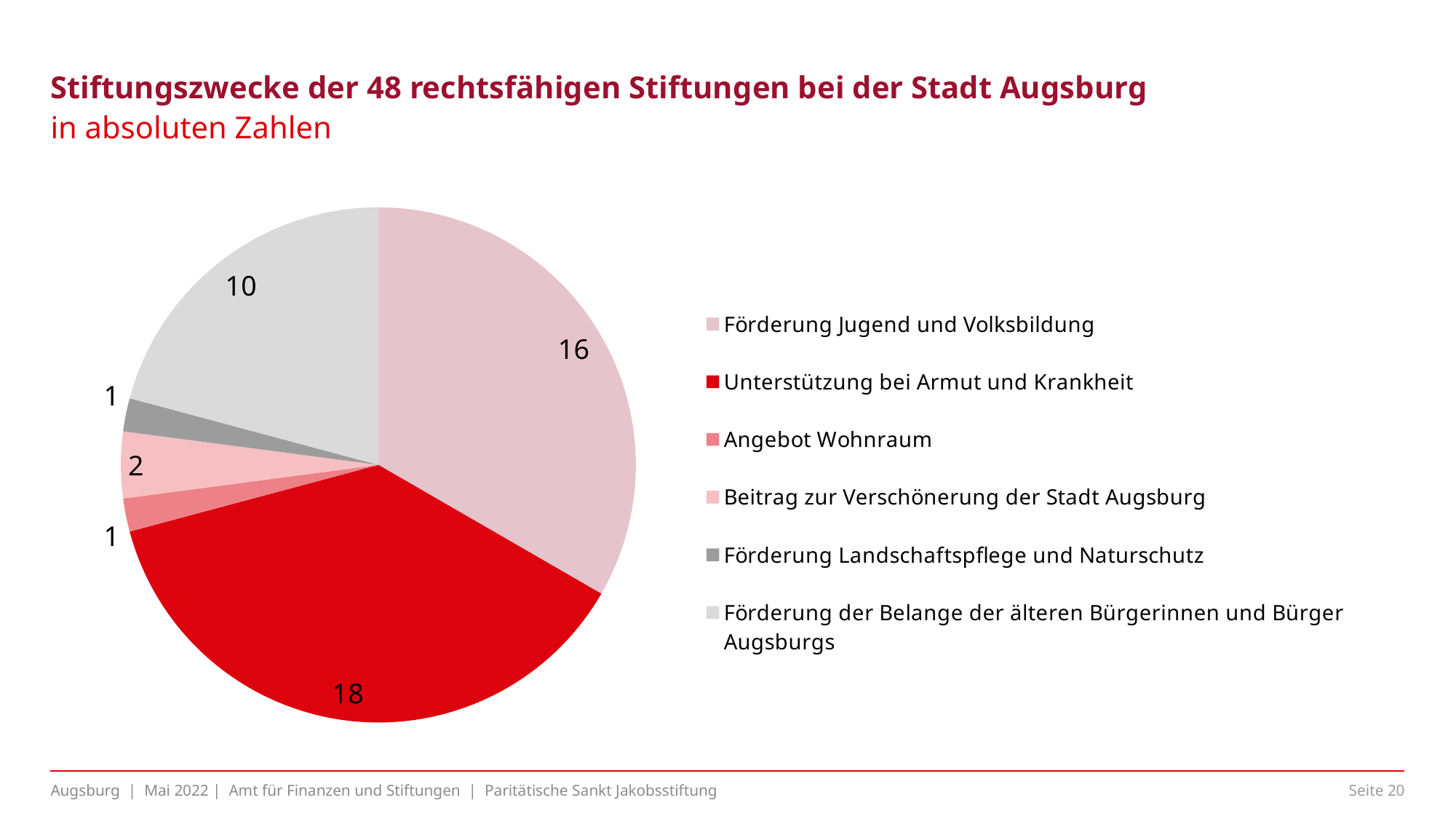
Which is larger: "Förderung Jugend und Volksbildung" or "Förderung der Belange der älteren Bürgerinnen und Bürger Augsburgs"? Förderung Jugend und Volksbildung What is the difference between the values for "Unterstützung bei Armut und Krankheit" and "Förderung Jugend und Volksbildung"? 2 What is the value for "Förderung der Belange der älteren Bürgerinnen und Bürger Augsburgs"? 10 How many categories does the pie chart have? 6 How many foundations have the purpose "Unterstützung bei Armut und Krankheit"? 18 What is the value for "Förderung Jugend und Volksbildung"? 16 What is the value for "Angebot Wohnraum"? 1 What colour is the slice for "Unterstützung bei Armut und Krankheit"? red What is the value for "Beitrag zur Verschönerung der Stadt Augsburg"? 2 Which purpose has the largest slice of the pie? Unterstützung bei Armut und Krankheit What type of chart is shown on the slide? pie chart What share of the pie does "Unterstützung bei Armut und Krankheit" represent? 37.5%